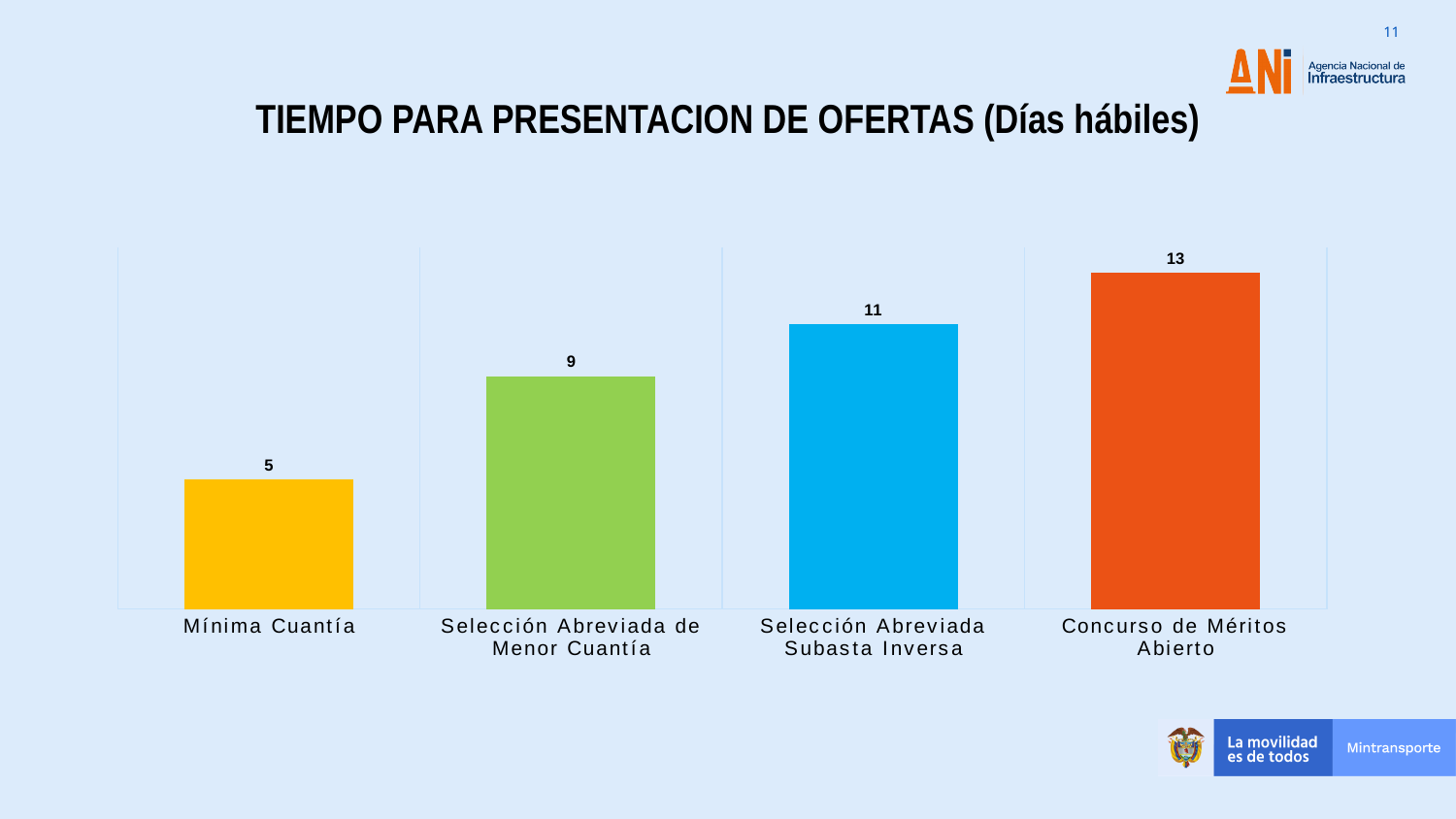
What is the value for Mínima Cuantía? 5 How many categories are shown in the chart? 4 What kind of chart is shown on the slide? Bar chart Which is larger, the value for Selección Abreviada Subasta Inversa or Selección Abreviada de Menor Cuantía? Selección Abreviada Subasta Inversa What is the value for Selección Abreviada Subasta Inversa? 11 Which category has the highest value? Concurso de Méritos Abierto What is the title of the chart? TIEMPO PARA PRESENTACION DE OFERTAS (Días hábiles) What is the value for Concurso de Méritos Abierto? 13 What is the value for Selección Abreviada de Menor Cuantía? 9 What is the difference between the values for Concurso de Méritos Abierto and Mínima Cuantía? 8 Which category has the lowest value? Mínima Cuantía Do the values rise or fall from left to right along the x axis? Rise